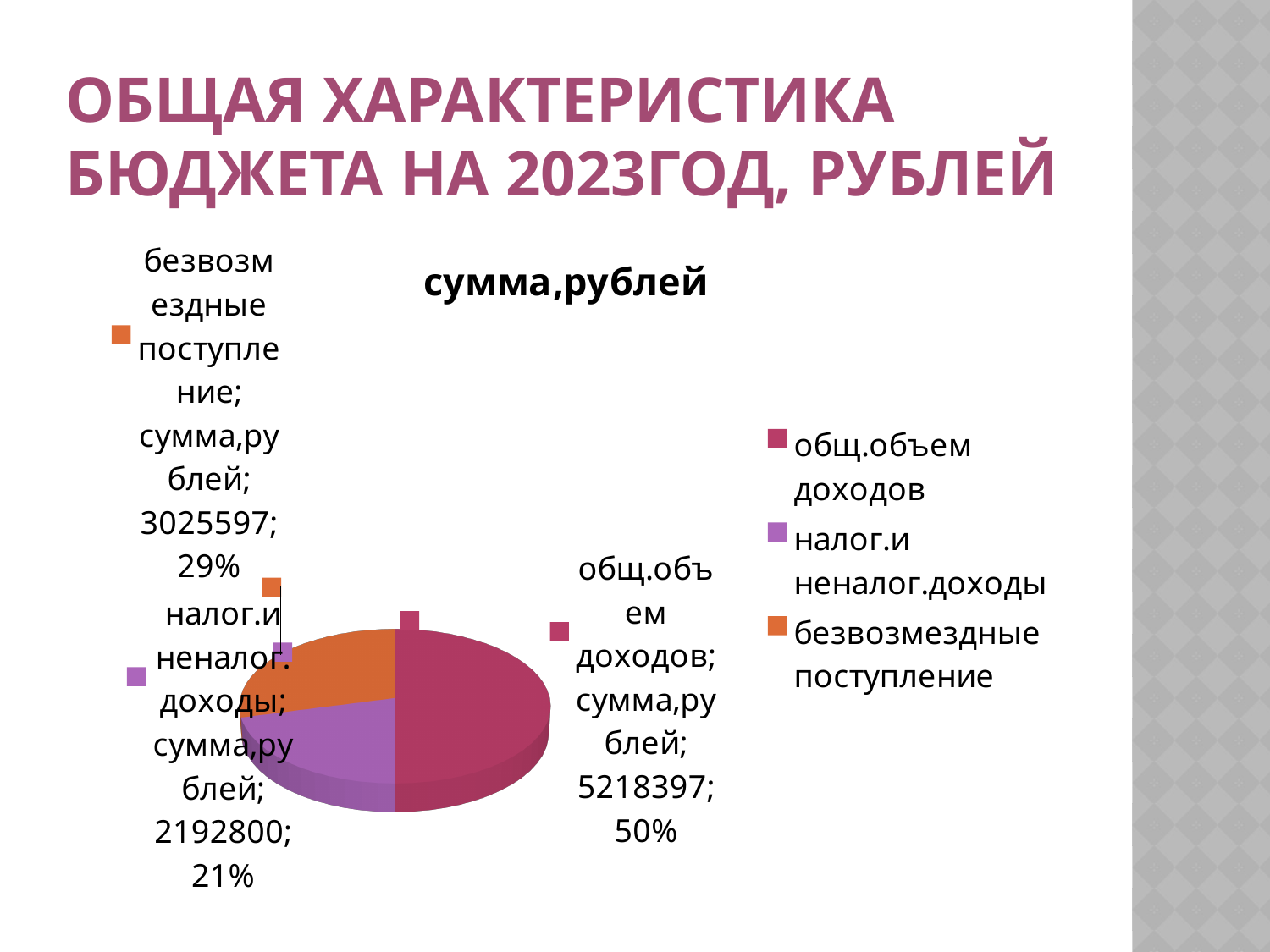
What is the value for общ.объем доходов? 5218397 Which is larger, the value for безвозмездные поступление or the value for налог.и неналог.доходы? безвозмездные поступление What kind of chart is shown on the slide? pie chart Which category has the largest slice? общ.объем доходов What is the difference between the values for безвозмездные поступление and налог.и неналог.доходы? 832797 How many slices does the pie chart have? 3 What share of the pie does общ.объем доходов take? 50% What is the chart's title? сумма,рублей What is the value for налог.и неналог.доходы? 2192800 What share of the pie does безвозмездные поступление take? 29% Which category has the smallest slice? налог.и неналог.доходы What is the value for безвозмездные поступление? 3025597